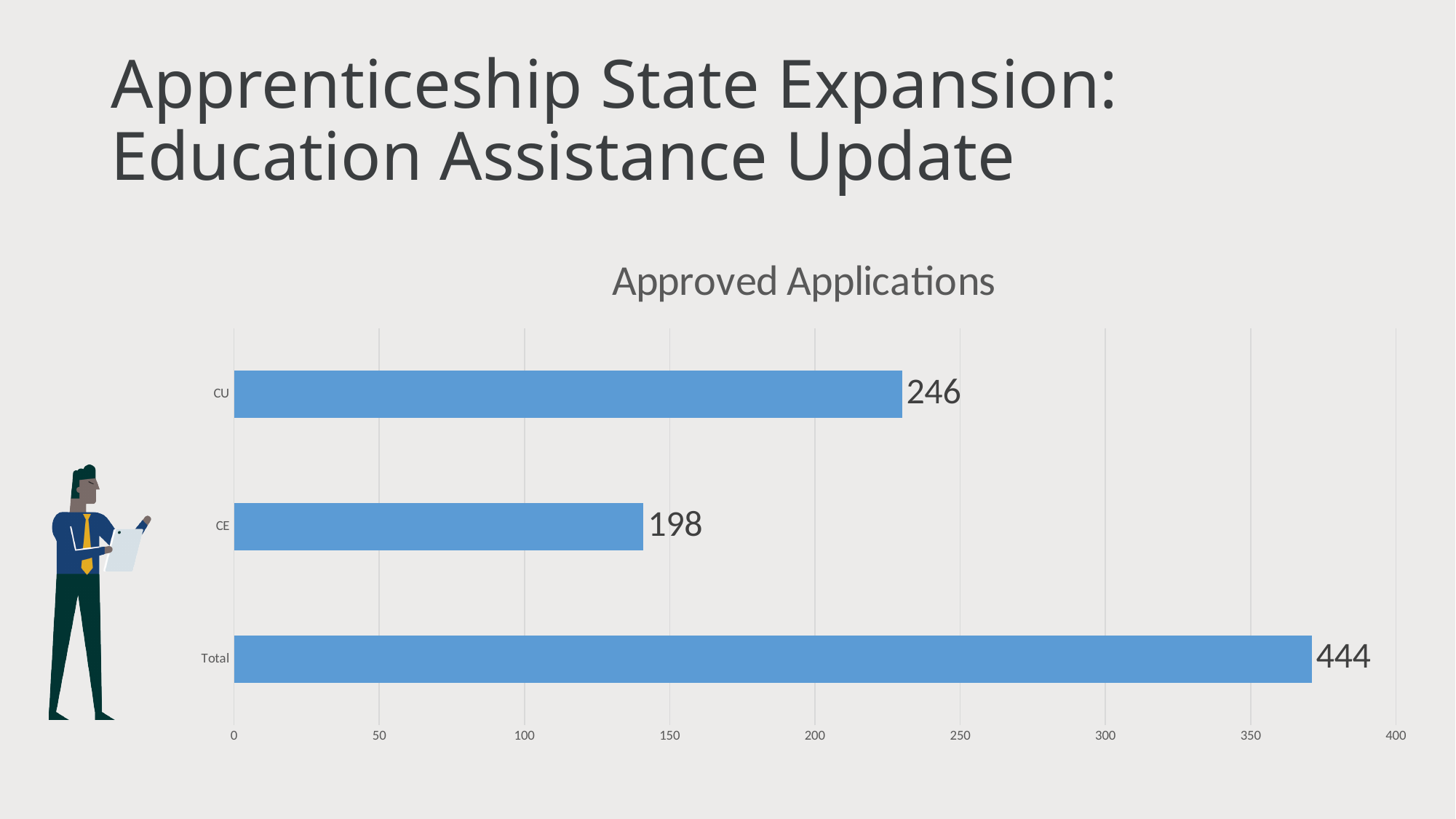
Which is larger, the value for CU or the value for CE? CU Is the value for CE greater or less than 200? less Which category has the lowest value in the Approved Applications chart? CE Which category has the highest value in the Approved Applications chart? Total How many categories are shown in the Approved Applications chart? 3 What is the value for CU in the Approved Applications chart? 246 What is the value for Total in the Approved Applications chart? 444 What is the title of the chart on the slide? Approved Applications What kind of chart is shown on the slide? Bar chart Is the value for Total greater or less than 350? greater What is the difference between the values for CU and CE? 48 What is the value for CE in the Approved Applications chart? 198